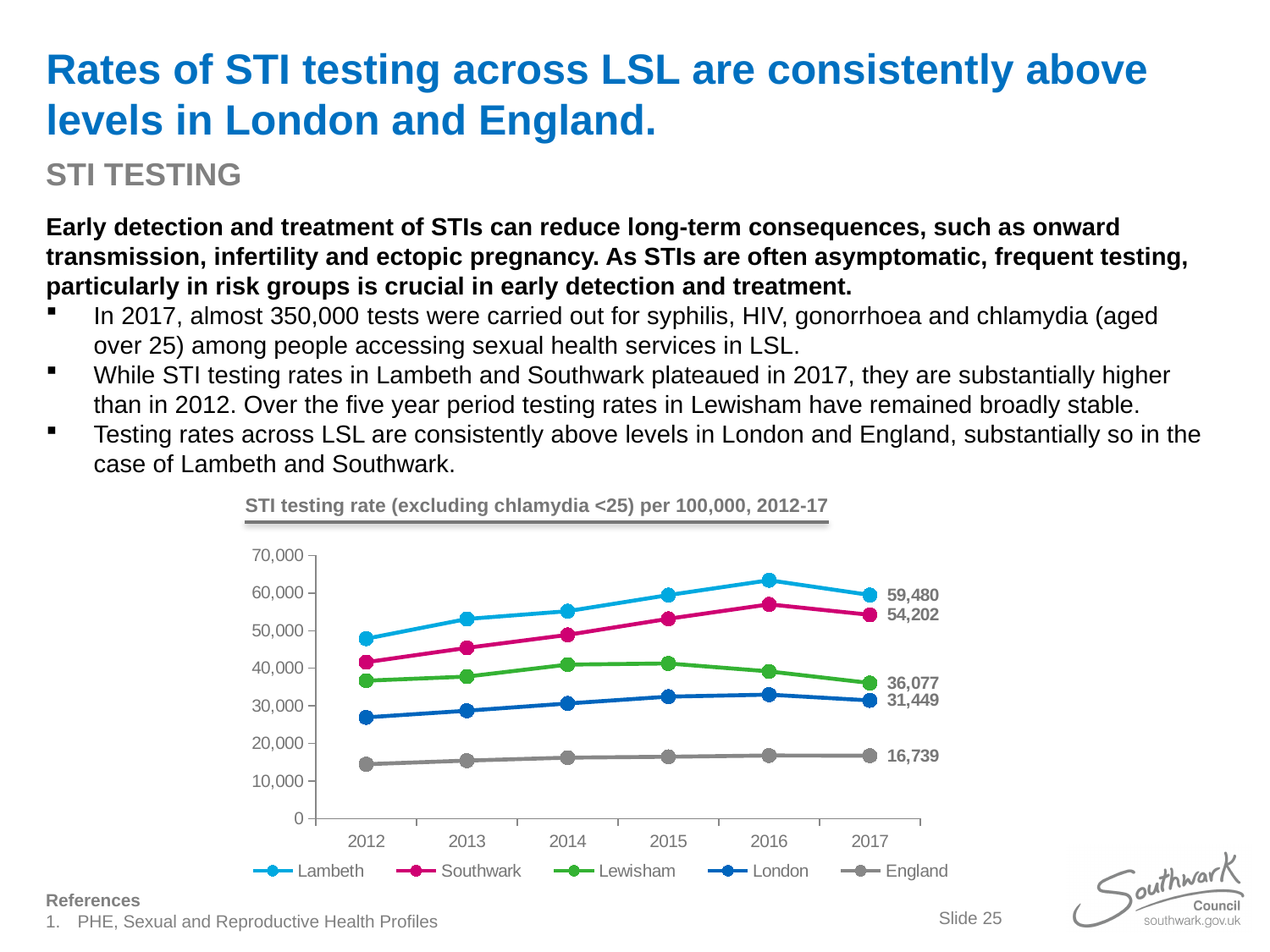
Which area has the lowest STI testing rate in 2017? England What is the STI testing rate for Southwark in 2017? 54,202 What kind of chart is shown on the slide? Line chart What is the STI testing rate for London in 2017? 31,449 What is the difference between the 2017 STI testing rates for Lambeth and Southwark? 5,278 What is the STI testing rate for England in 2017? 16,739 How many years are shown on the x axis? 6 How many series does the legend list? 5 What is the STI testing rate for Lambeth in 2017? 59,480 Which area has the highest STI testing rate in 2017? Lambeth Which is larger in 2017, the STI testing rate for Lewisham or for London? Lewisham Is the STI testing rate for Lambeth in 2012 greater or less than 40,000? greater